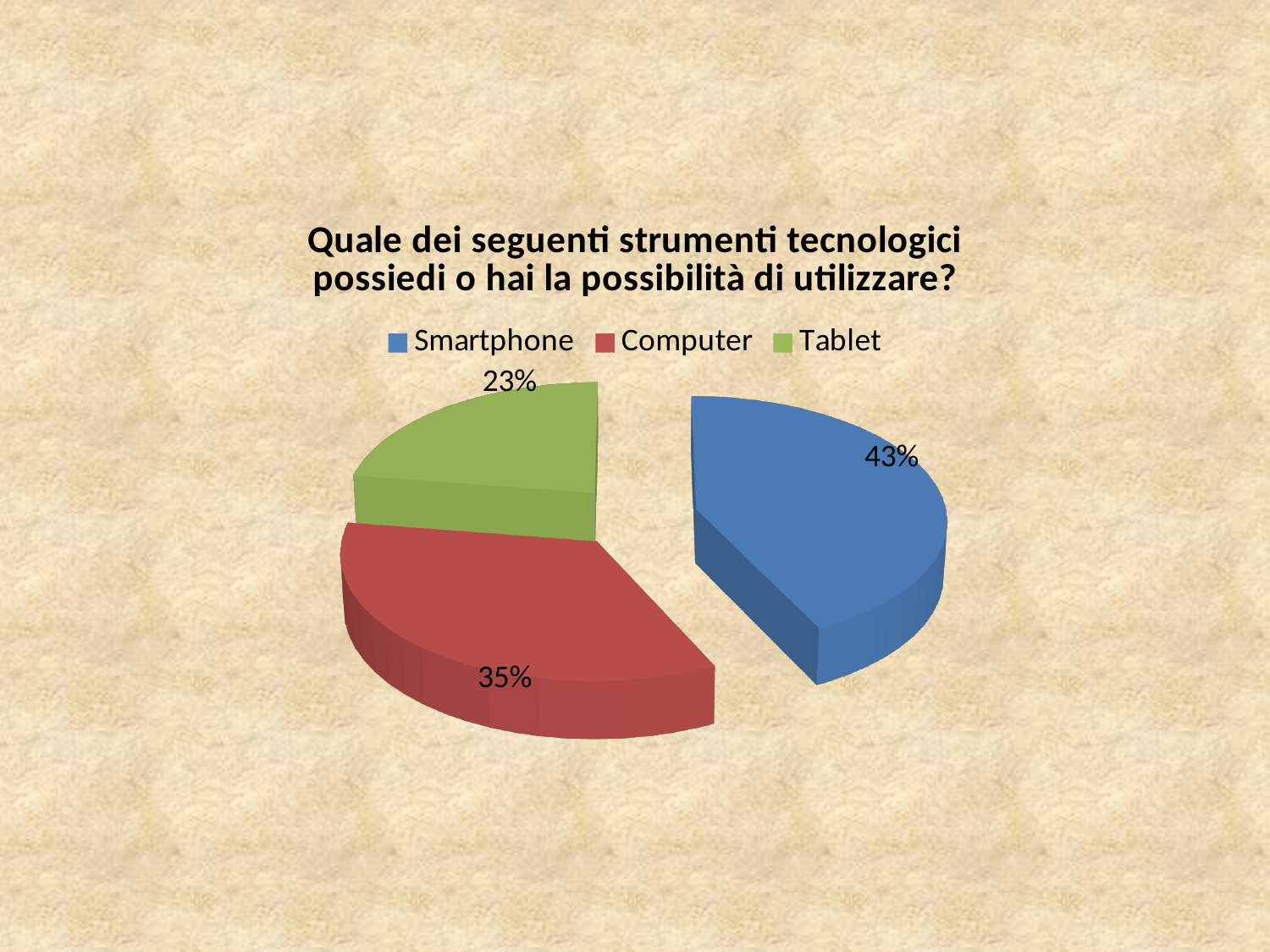
What kind of chart is shown on the slide? Pie chart How many categories are shown in the pie chart? 3 What share of the pie does Smartphone represent? 43% What is the title of the chart? Quale dei seguenti strumenti tecnologici possiedi o hai la possibilità di utilizzare? What is the difference in percentage points between the Computer and Tablet slices? 12 Which category has the smallest slice of the pie? Tablet What share of the pie does Tablet represent? 23% What is the difference in percentage points between the Smartphone and Computer slices? 8 Which colour represents Computer in the pie chart? Red Which slice is larger, Computer or Tablet? Computer What share of the pie does Computer represent? 35% Which category has the largest slice of the pie? Smartphone